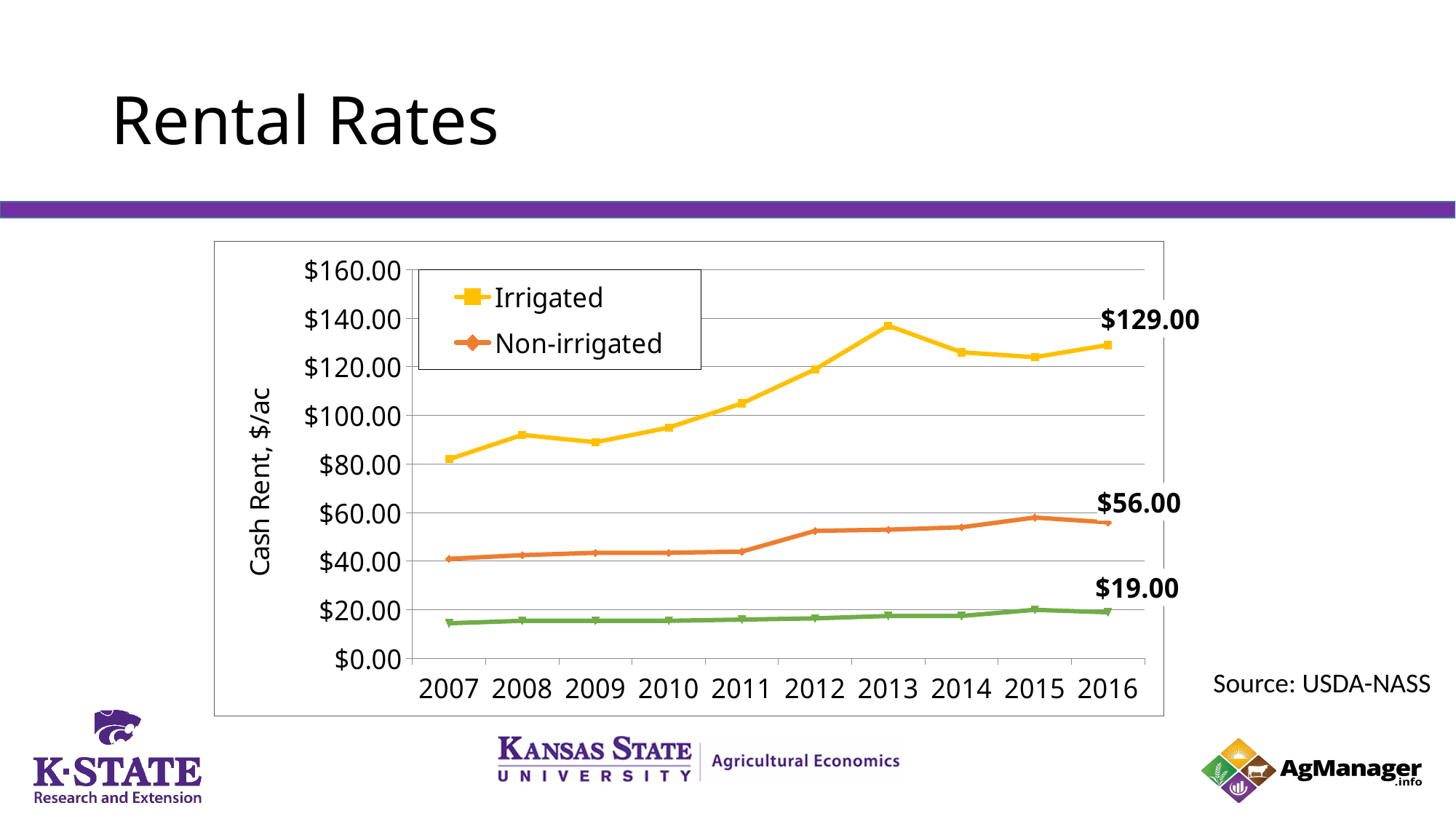
How many series does the legend list? 2 What is the difference between the labeled 2016 Irrigated value and the labeled 2016 Non-irrigated value? $73.00 Is the Non-irrigated value for 2007 greater or less than $60.00? less Does the Irrigated series rise or fall from 2007 to 2013? Rise How many years are shown on the x axis? 10 What is the Non-irrigated cash rent value labeled for 2016? $56.00 Is the Irrigated value for 2013 greater or less than $120.00? greater In 2016, which is larger, the Irrigated value or the Non-irrigated value? Irrigated What kind of chart is shown on the slide? Line chart What is the label on the y axis? Cash Rent, $/ac In which year does the Irrigated series reach its highest value? 2013 What is the Irrigated cash rent value labeled for 2016? $129.00